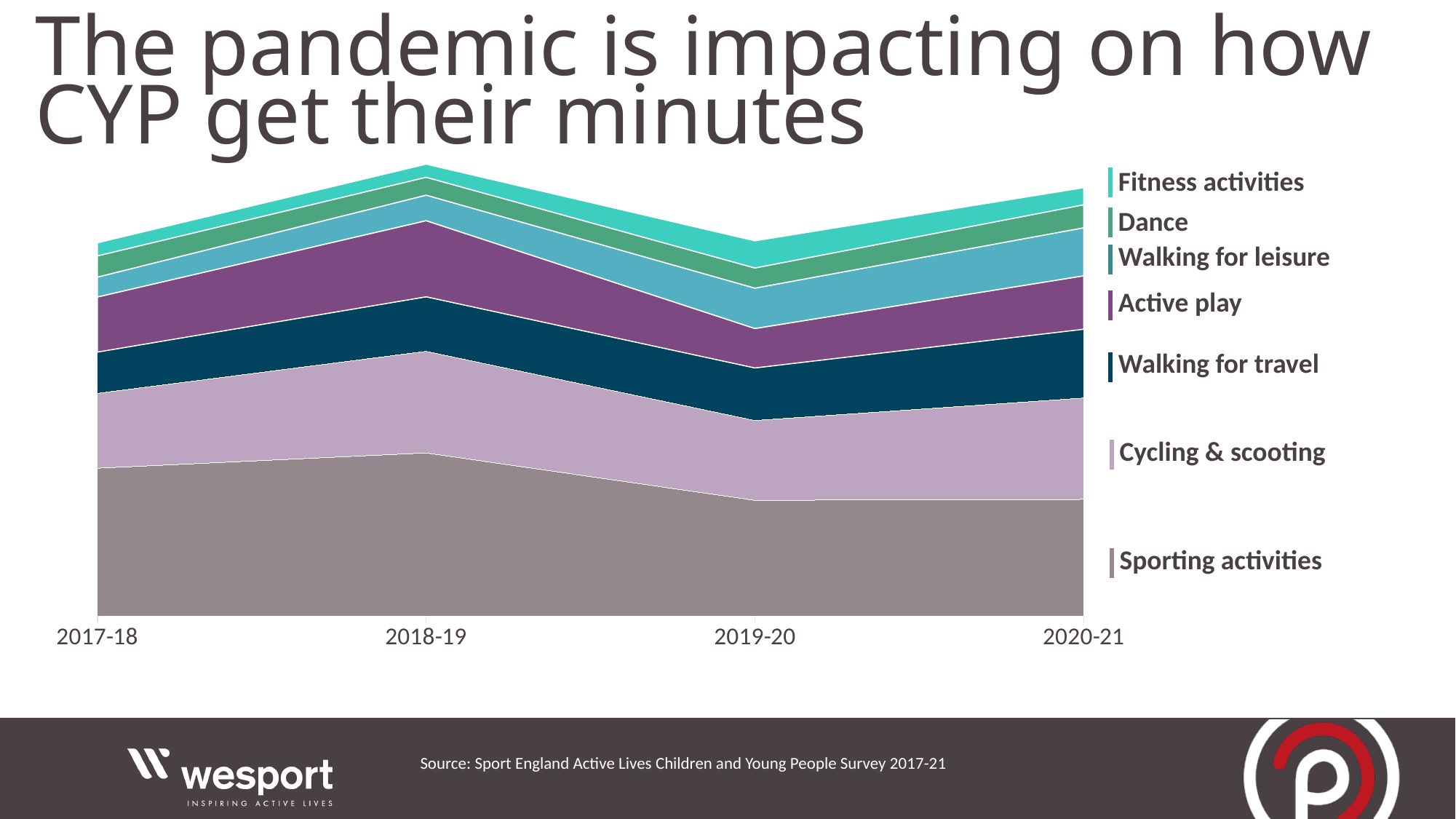
What kind of chart is shown on the slide? Stacked area chart Which series occupies the largest band in the chart? Sporting activities How many survey years are shown along the x axis of the chart? 4 Does the total stacked height rise or fall from 2019-20 to 2020-21? Rise What colour is used for the Sporting activities series? Grey In 2020-21, which band is larger: Sporting activities or Cycling & scooting? Sporting activities How many series does the chart's legend list? 7 Does the total stacked height rise or fall from 2018-19 to 2019-20? Fall Does the Sporting activities band rise or fall from 2018-19 to 2019-20? Fall Which series is listed first (at the top) in the chart's legend? Fitness activities In which year is the total stacked height of the chart highest? 2018-19